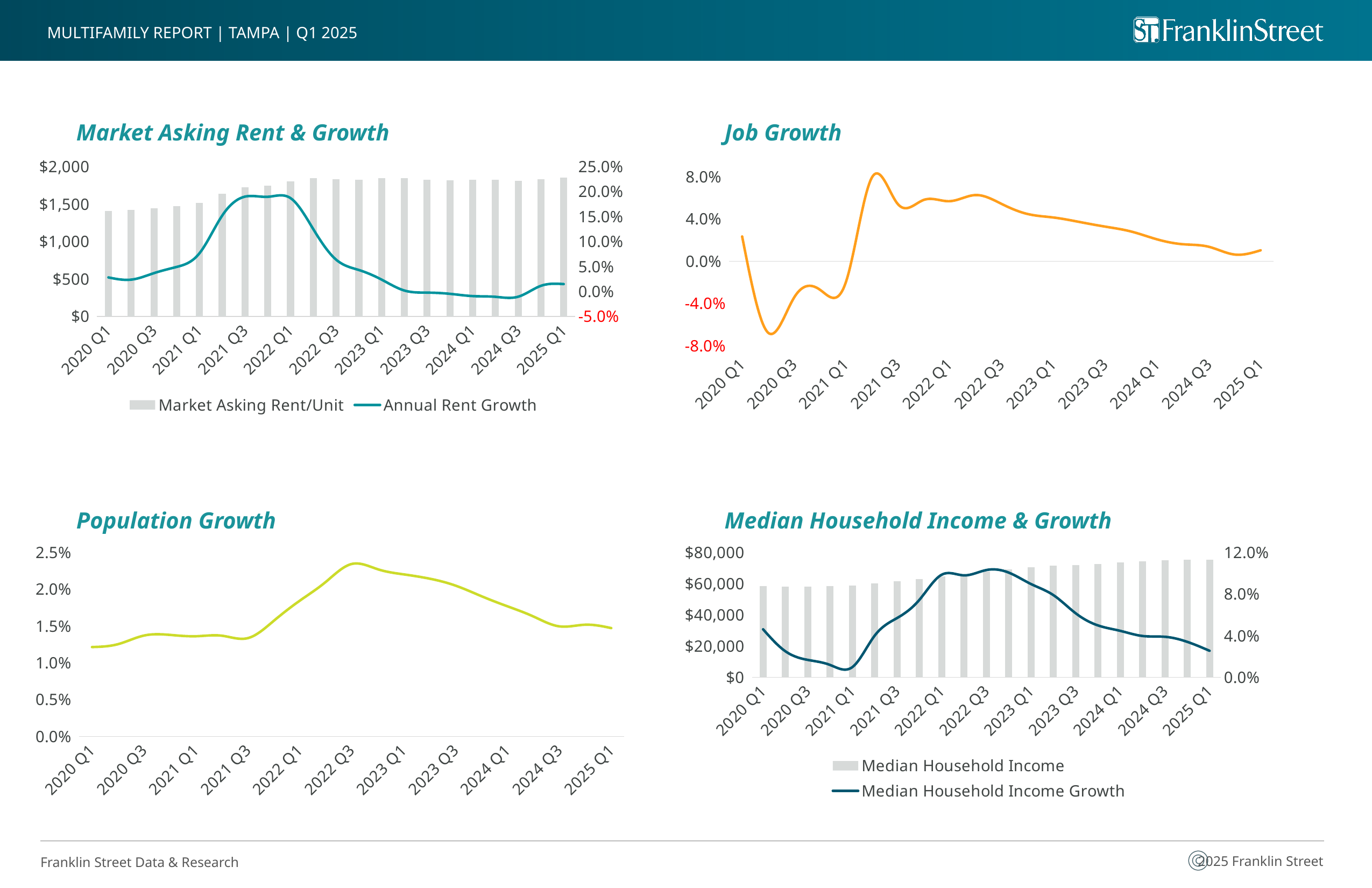
How many charts are shown on the slide? 4 On the Population Growth chart, is the value for 2022 Q3 greater or less than 2.0%? greater On the Median Household Income & Growth chart, is the Median Household Income for 2025 Q1 greater or less than $60,000? greater On the Job Growth chart, is the value for 2021 Q3 greater or less than 4.0%? greater What kind of chart is the Market Asking Rent & Growth chart? Combined bar and line chart On the Median Household Income & Growth chart, how many series does the legend list? 2 On the Job Growth chart, does the line rise or fall from 2022 Q3 to 2025 Q1? Falls What kind of chart is the Job Growth chart? Line chart On the Market Asking Rent & Growth chart, how many series does the legend list? 2